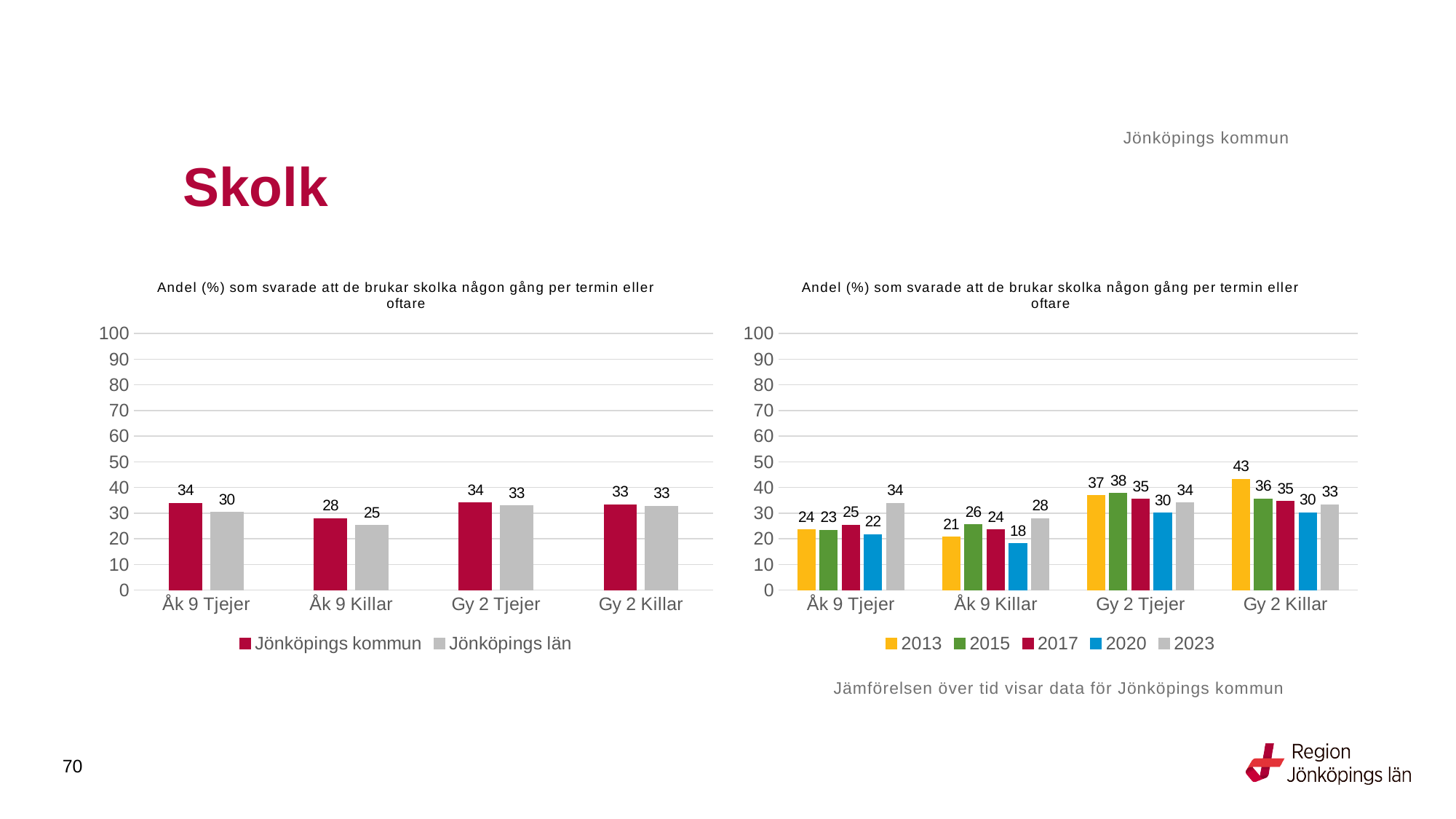
What kind of chart is the right chart? Bar chart In the left chart, which category has the lowest value for Jönköpings län? Åk 9 Killar In the left chart, what is the value for Jönköpings län for Åk 9 Tjejer? 30 In the right chart, how many series does the legend list? 5 In the right chart, what is the value for 2020 for Åk 9 Killar? 18 In the right chart, which year has the highest value for Åk 9 Tjejer? 2023 In the right chart, what is the value for 2013 for Gy 2 Killar? 43 In the left chart, what is the difference between Jönköpings kommun and Jönköpings län for Åk 9 Tjejer? 4 In the right chart, what is the difference between the 2013 and 2023 values for Gy 2 Killar? 10 In the left chart, what is the value for Jönköpings kommun for Åk 9 Killar? 28 In the left chart, how many series does the legend list? 2 In the right chart, which is larger for Gy 2 Tjejer: the value for 2015 or the value for 2020? 2015